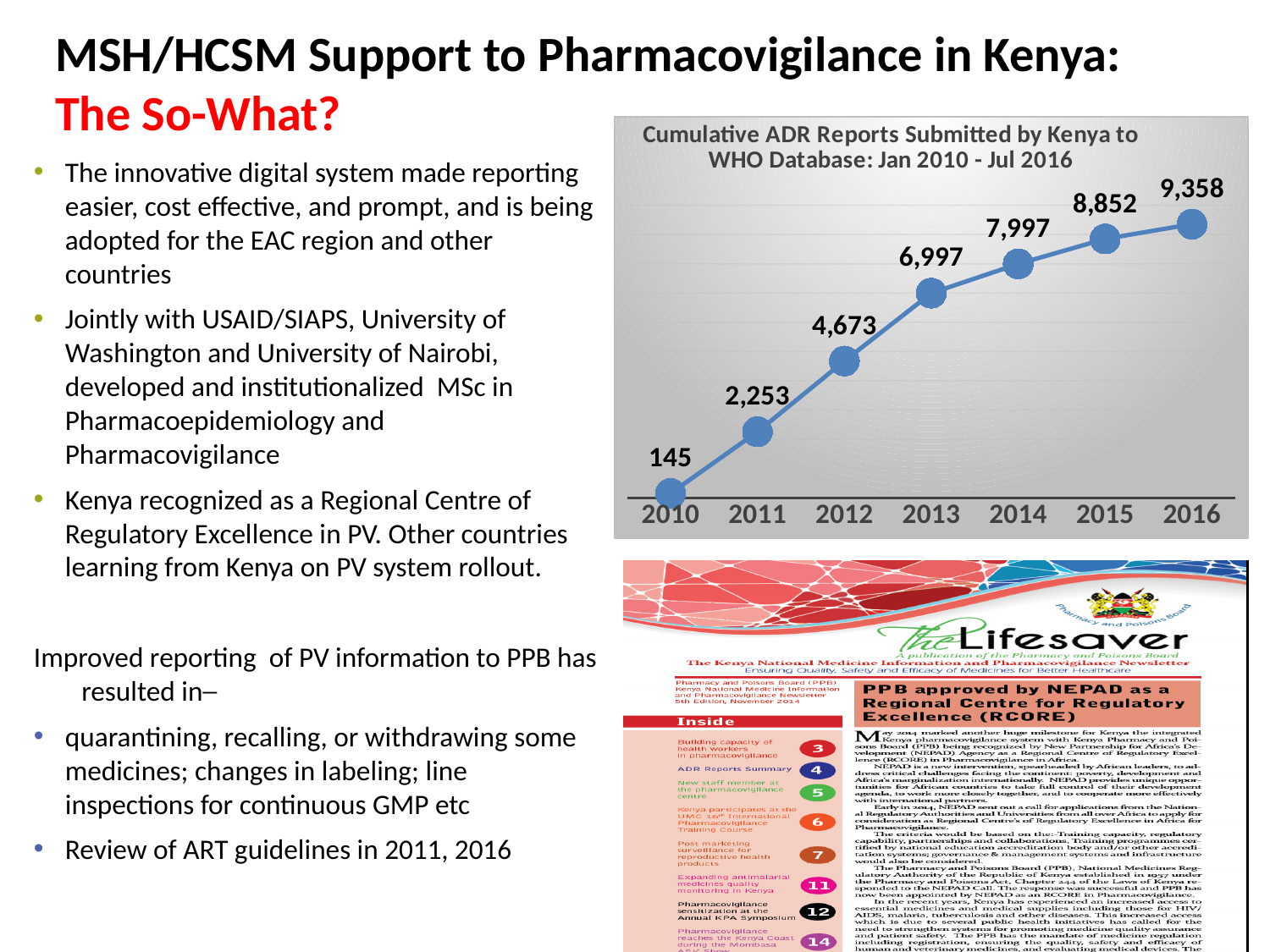
What is the title of the chart on the slide? Cumulative ADR Reports Submitted by Kenya to WHO Database: Jan 2010 - Jul 2016 Which year has the highest cumulative ADR report value on the chart? 2016 What is the cumulative number of ADR reports shown for 2013? 6,997 What is the cumulative number of ADR reports shown for 2016? 9,358 What kind of chart is used to show the cumulative ADR reports? Line chart What is the cumulative number of ADR reports shown for 2010? 145 Which year has a larger cumulative ADR report value, 2014 or 2013? 2014 How many years are plotted on the chart? 7 What is the difference between the cumulative ADR reports for 2016 and 2015? 506 Do the cumulative ADR report values rise or fall from 2010 to 2016? Rise Which year has the lowest cumulative ADR report value on the chart? 2010 What is the difference between the cumulative ADR reports for 2012 and 2011? 2,420